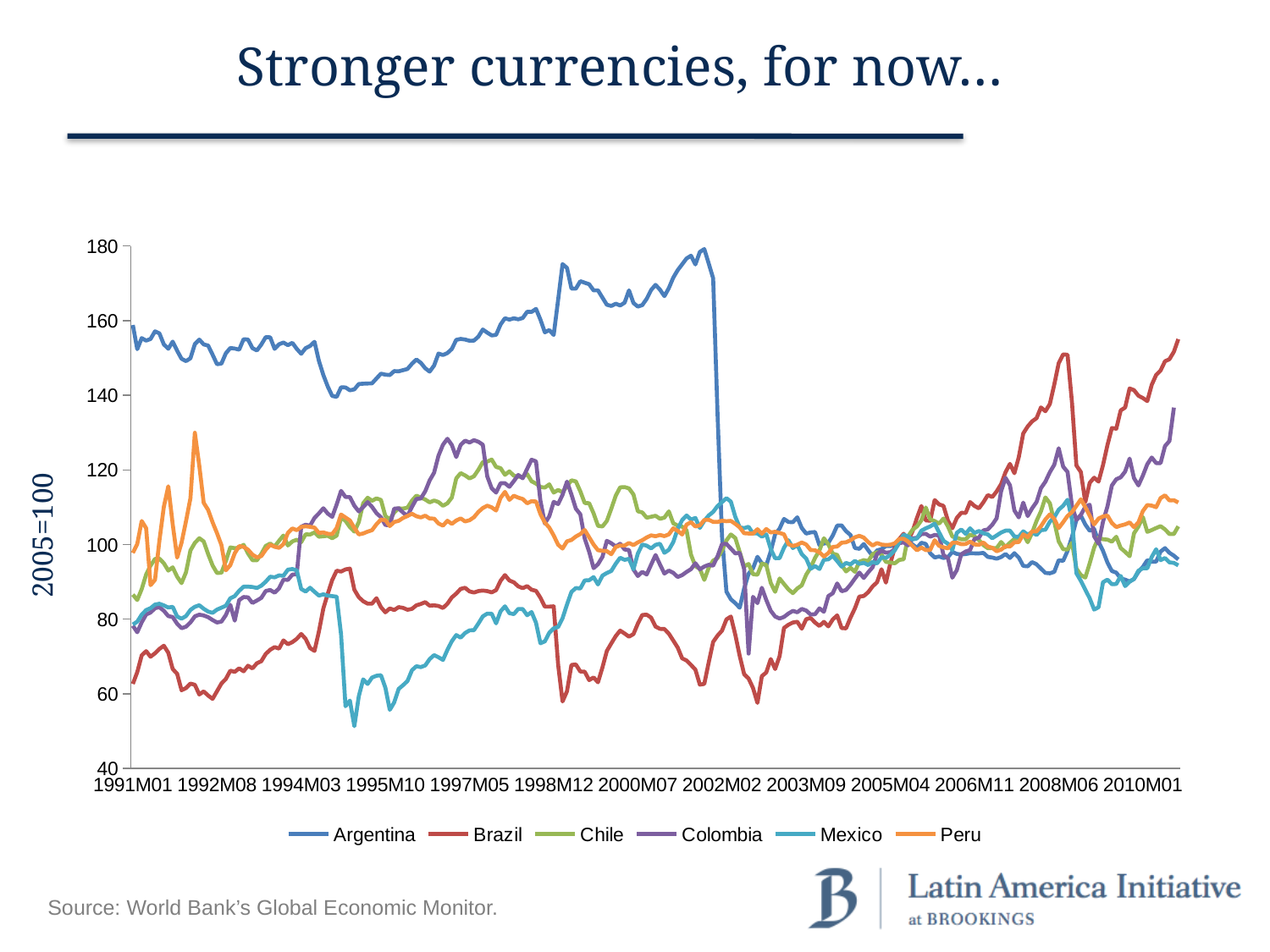
Does the Brazil line rise or fall between 2003M09 and 2010M01? rise Does the Argentina line rise or fall between 1991M01 and 2010M01 overall? fall What kind of chart is shown on the slide? line chart Is the lowest value for Mexico, reached around 1995M10, greater or less than 60? less What is the label on the vertical axis? 2005=100 Which series has the highest value at the right end of the chart (2010M01 onward)? Brazil How many series does the legend list? 6 Which series has the highest value at 1991M01? Argentina Is the value for Brazil at 1992M08 greater or less than 80? less Is the value for Argentina at 1991M01 greater or less than 140? greater Which series has the lowest value at 1991M01? Brazil What is the title of the slide? Stronger currencies, for now...